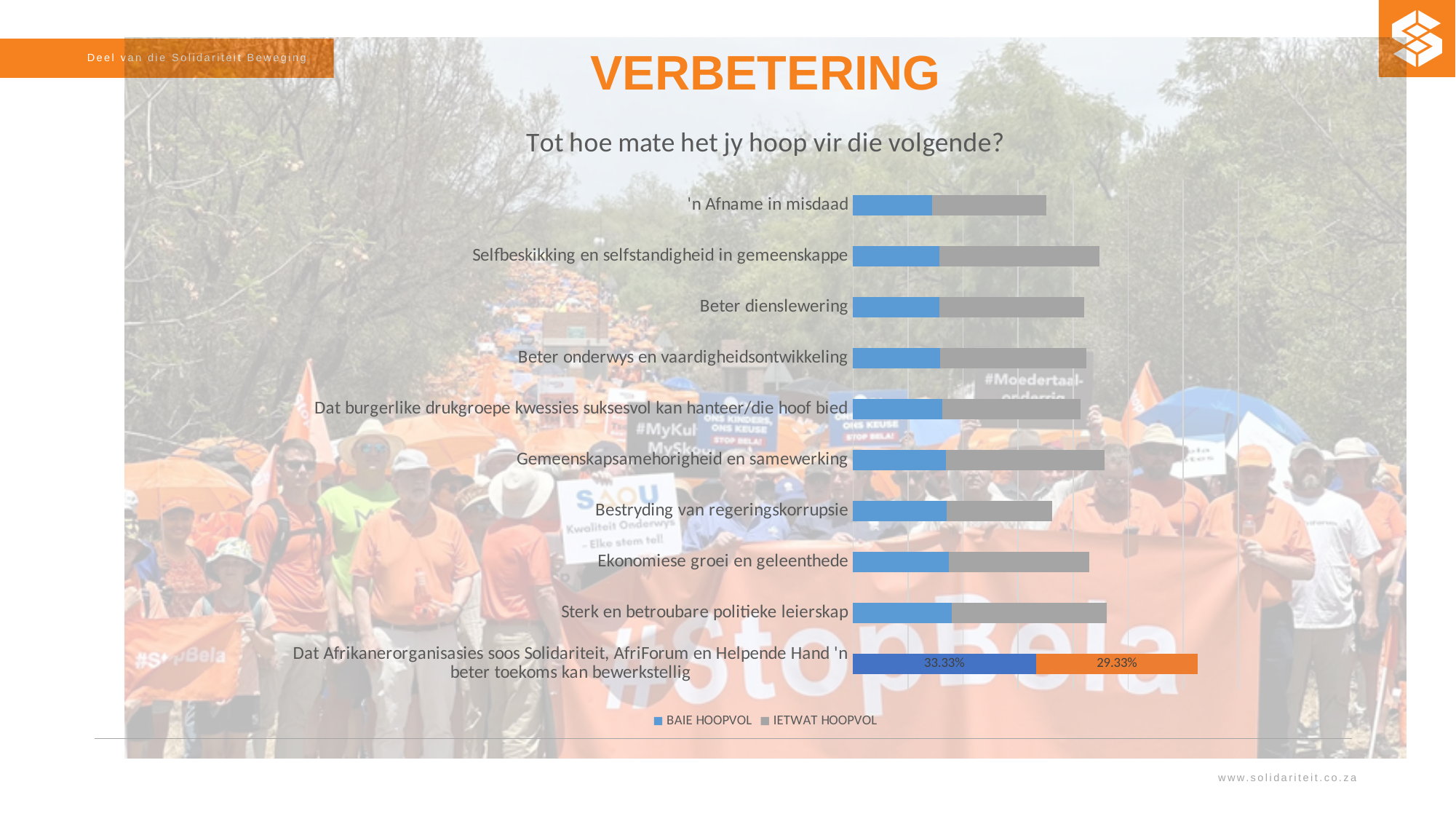
What question is shown as the chart's title? Tot hoe mate het jy hoop vir die volgende? Which has the larger BAIE HOOPVOL value: ''n Afname in misdaad' or 'Dat Afrikanerorganisasies soos Solidariteit, AfriForum en Helpende Hand 'n beter toekoms kan bewerkstellig'? Dat Afrikanerorganisasies soos Solidariteit, AfriForum en Helpende Hand 'n beter toekoms kan bewerkstellig How many categories are plotted in the chart? 10 For 'Dat Afrikanerorganisasies soos Solidariteit, AfriForum en Helpende Hand 'n beter toekoms kan bewerkstellig', which is larger: BAIE HOOPVOL or IETWAT HOOPVOL? BAIE HOOPVOL How many series does the legend list? 2 What is the IETWAT HOOPVOL value for 'Dat Afrikanerorganisasies soos Solidariteit, AfriForum en Helpende Hand 'n beter toekoms kan bewerkstellig'? 29.33% What is the difference between the BAIE HOOPVOL and IETWAT HOOPVOL values for 'Dat Afrikanerorganisasies soos Solidariteit, AfriForum en Helpende Hand 'n beter toekoms kan bewerkstellig'? 4.00% Which category has the longest total stacked bar? Dat Afrikanerorganisasies soos Solidariteit, AfriForum en Helpende Hand 'n beter toekoms kan bewerkstellig What is the total of the stacked bar for 'Dat Afrikanerorganisasies soos Solidariteit, AfriForum en Helpende Hand 'n beter toekoms kan bewerkstellig'? 62.66% What kind of chart is shown on the slide? Stacked bar chart What is the BAIE HOOPVOL value for 'Dat Afrikanerorganisasies soos Solidariteit, AfriForum en Helpende Hand 'n beter toekoms kan bewerkstellig'? 33.33% What are the two series named in the legend? BAIE HOOPVOL and IETWAT HOOPVOL